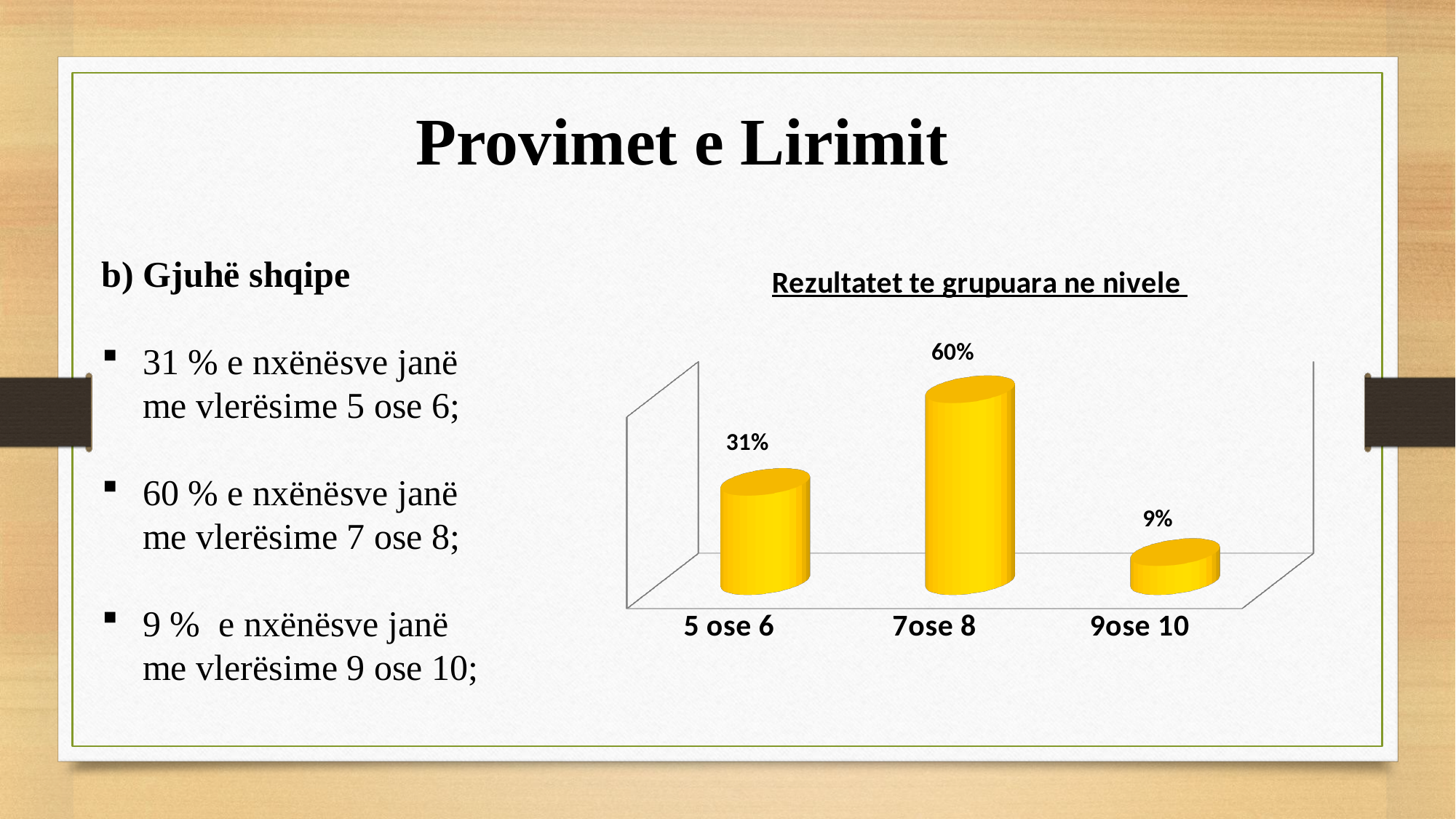
What is the difference between the values for '5 ose 6' and '9ose 10'? 22% What is the difference between the values for '7ose 8' and '5 ose 6'? 29% Which category has the lowest value? 9ose 10 How many categories are shown on the x axis? 3 What is the value for the '9ose 10' category? 9% What is the title of the chart? Rezultatet te grupuara ne nivele What kind of chart is shown on the slide? bar chart What colour are the bars in the chart? yellow Which is larger, the value for '5 ose 6' or the value for '9ose 10'? 5 ose 6 What is the value for the '7ose 8' category? 60% Which category has the highest value? 7ose 8 What is the value for the '5 ose 6' category? 31%